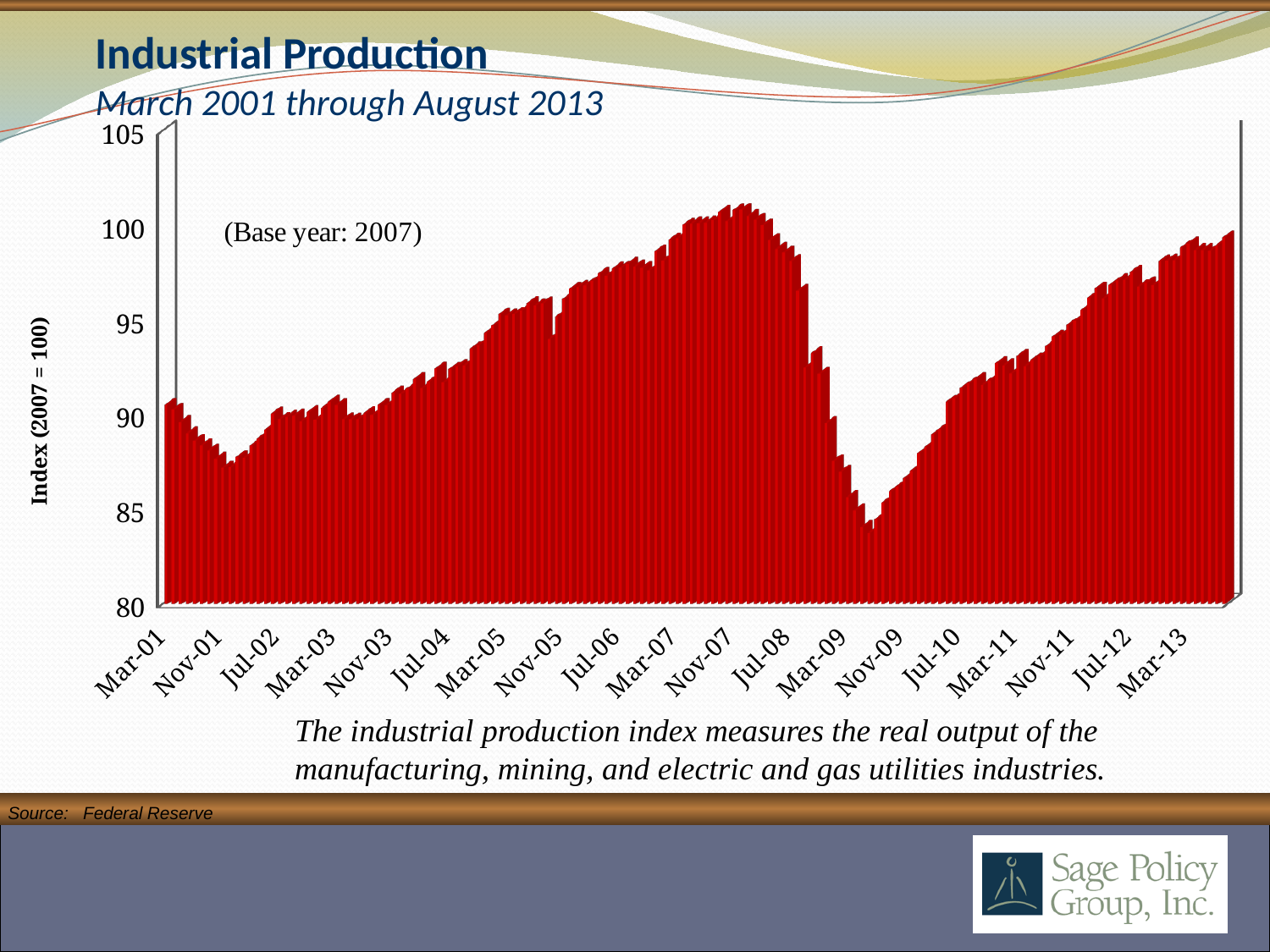
Is the value for Jul-12 greater or less than 95? greater Is the value for Nov-09 greater or less than 90? less Is the value for Mar-11 greater or less than 90? greater Do the values rise or fall between Nov-09 and Mar-13? Rise What kind of chart is shown on the slide? Bar chart What is the title of the chart on the slide? Industrial Production Which is larger, the value for Nov-07 or the value for Nov-09? Nov-07 Do the values rise or fall between Nov-07 and Mar-09? Fall Which is larger, the value for Mar-09 or the value for Mar-13? Mar-13 What is the label on the vertical axis of the chart? Index (2007 = 100)